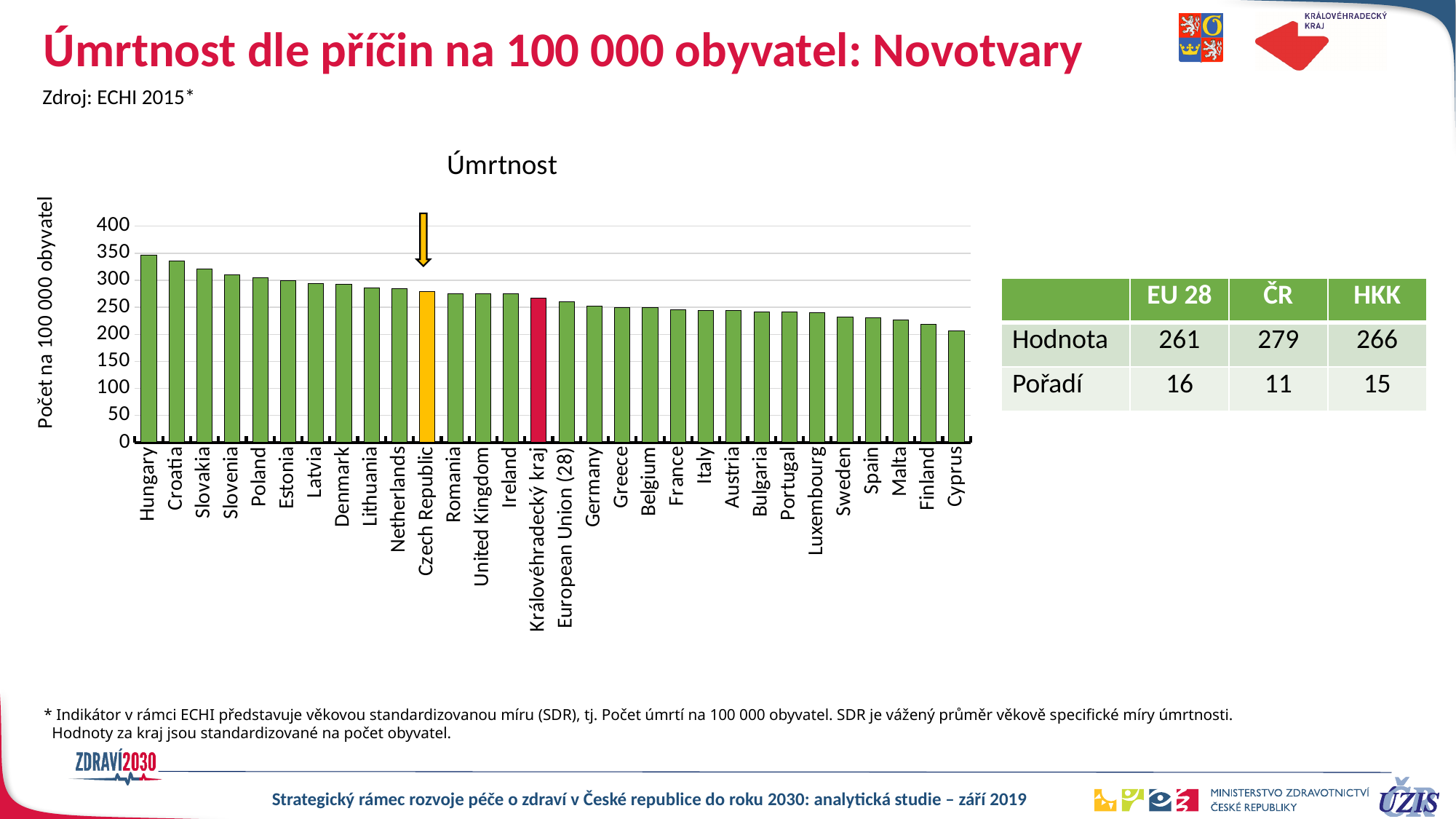
What is the label of the y axis of the chart? Počet na 100 000 obyvatel How many categories are plotted on the x axis of the Úmrtnost chart? 30 Do the values rise or fall from left to right along the x axis? fall Which is larger, the value for Hungary or the value for Cyprus? Hungary Which category has the highest value in the Úmrtnost chart? Hungary What kind of chart is shown on the slide? bar chart Is the value for Cyprus greater or less than 250? less Is the value for Finland greater or less than 250? less According to the table, what is the value (Hodnota) for ČR? 279 Is the value for Hungary greater or less than 300? greater According to the table, what is the difference between the value for ČR and the value for HKK? 13 Which category has the lowest value in the Úmrtnost chart? Cyprus